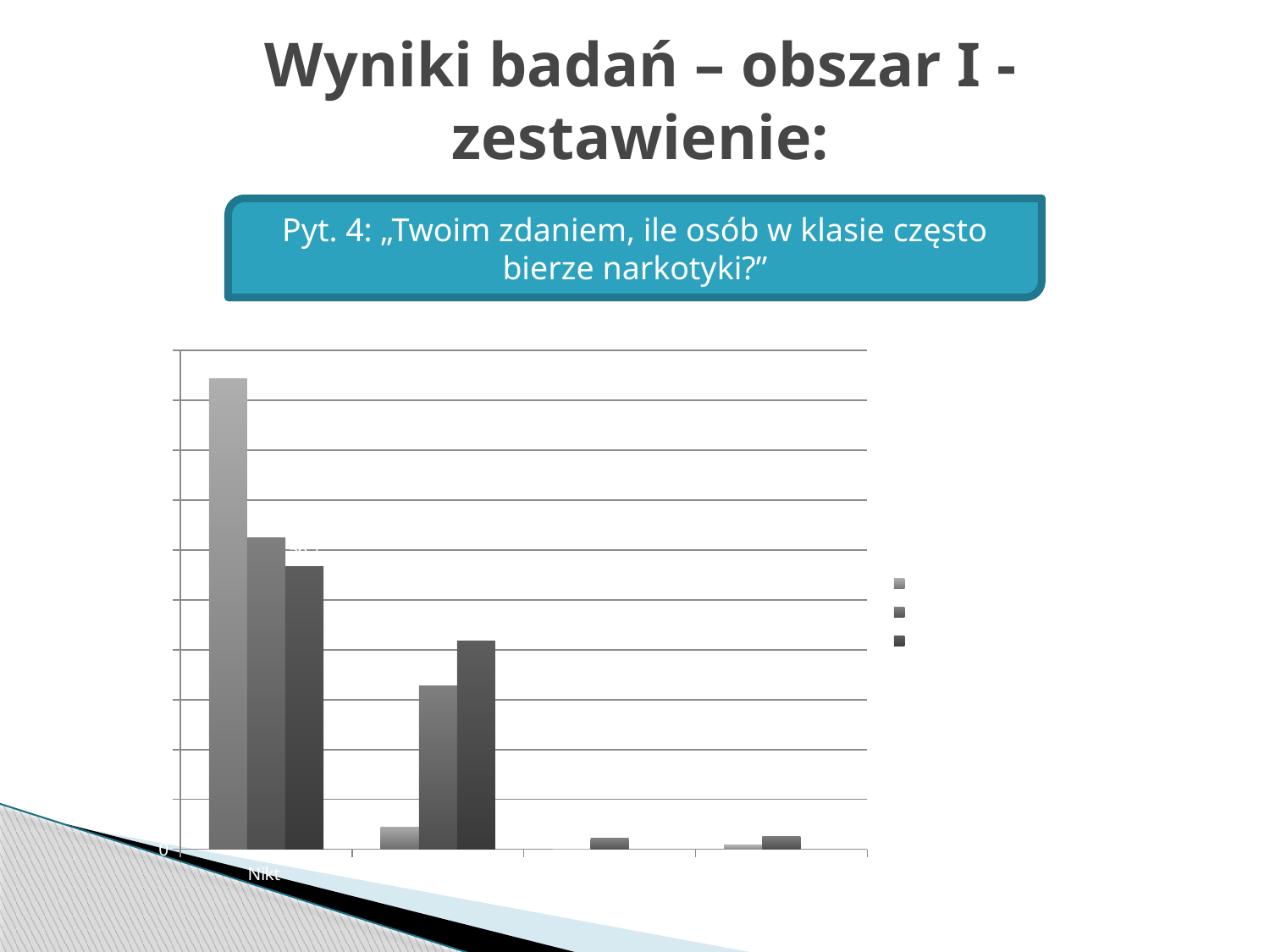
For the category "Nikt", is the lightest grey bar taller or shorter than the darkest grey bar? taller How many category groups are plotted along the x axis? 4 For the category "Nikt", which series has the highest bar: the lightest grey, the medium grey, or the darkest grey? the lightest grey What value is shown at the bottom of the vertical axis? 0 What kind of chart is shown on the slide? bar chart How many series does the legend list? 3 What is the label of the first category on the x axis? Nikt Do the values of the lightest grey series rise or fall moving from the first category to the last along the x axis? fall Which category has the tallest bar in the chart? Nikt